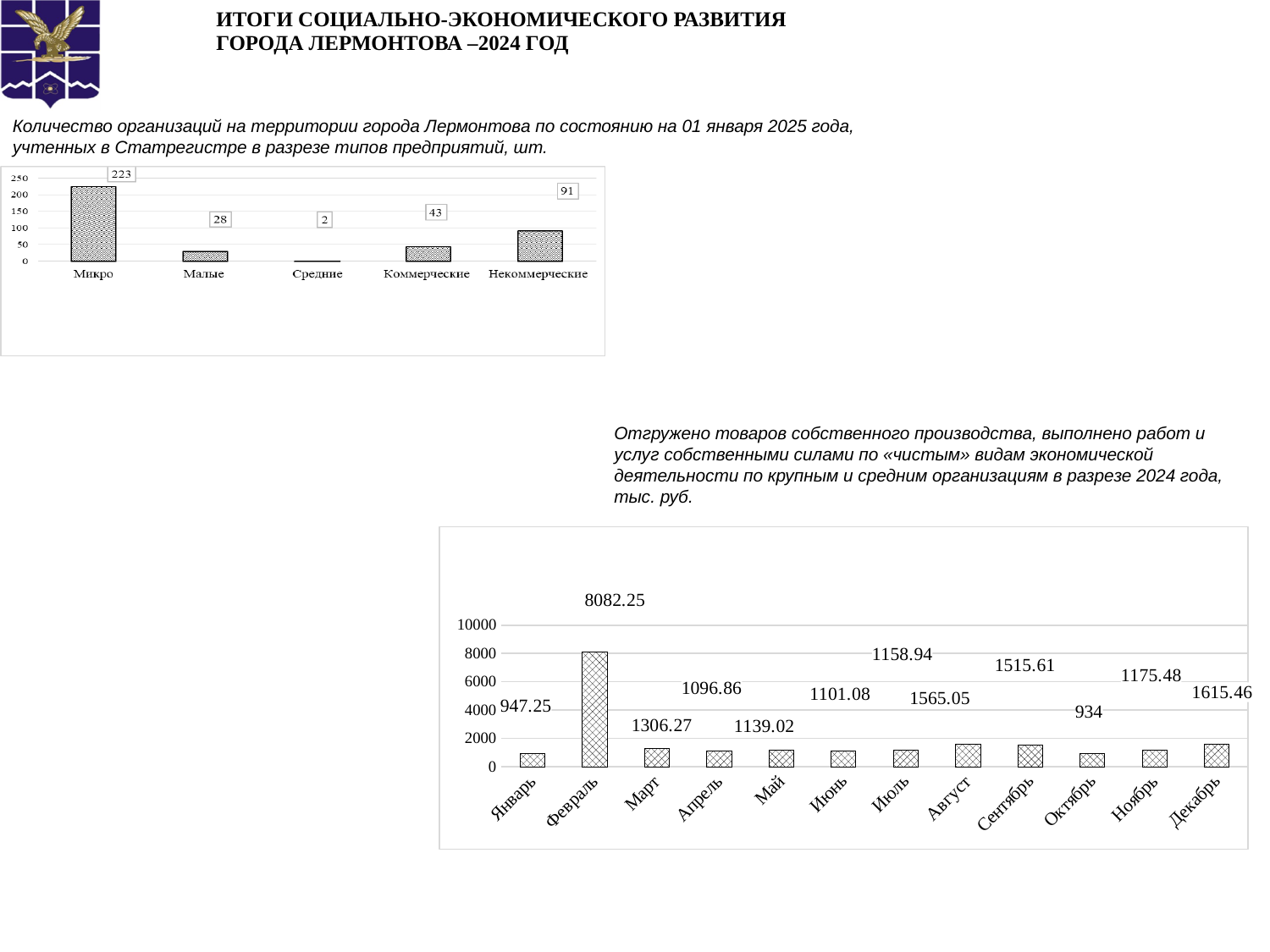
In the bottom chart (goods shipped by month, тыс. руб.), what is the value for Октябрь? 934 In the bottom chart (goods shipped by month, тыс. руб.), which month has the highest value? Февраль In the top chart (number of organizations by enterprise type), what is the difference between Коммерческие and Малые? 15 In the bottom chart (goods shipped by month, тыс. руб.), which is larger: Август or Сентябрь? Август In the bottom chart (goods shipped by month, тыс. руб.), how many months are plotted? 12 In the bottom chart (goods shipped by month, тыс. руб.), what is the value for Февраль? 8082.25 In the top chart (number of organizations by enterprise type), how many categories are shown? 5 In the top chart (number of organizations by enterprise type), what is the value for Микро? 223 In the bottom chart (goods shipped by month, тыс. руб.), what is the difference between Декабрь and Январь? 668.21 In the top chart (number of organizations by enterprise type), which category has the lowest value? Средние In the top chart (number of organizations by enterprise type), what is the value for Некоммерческие? 91 What type of chart is the bottom chart (goods shipped by month)? Bar chart